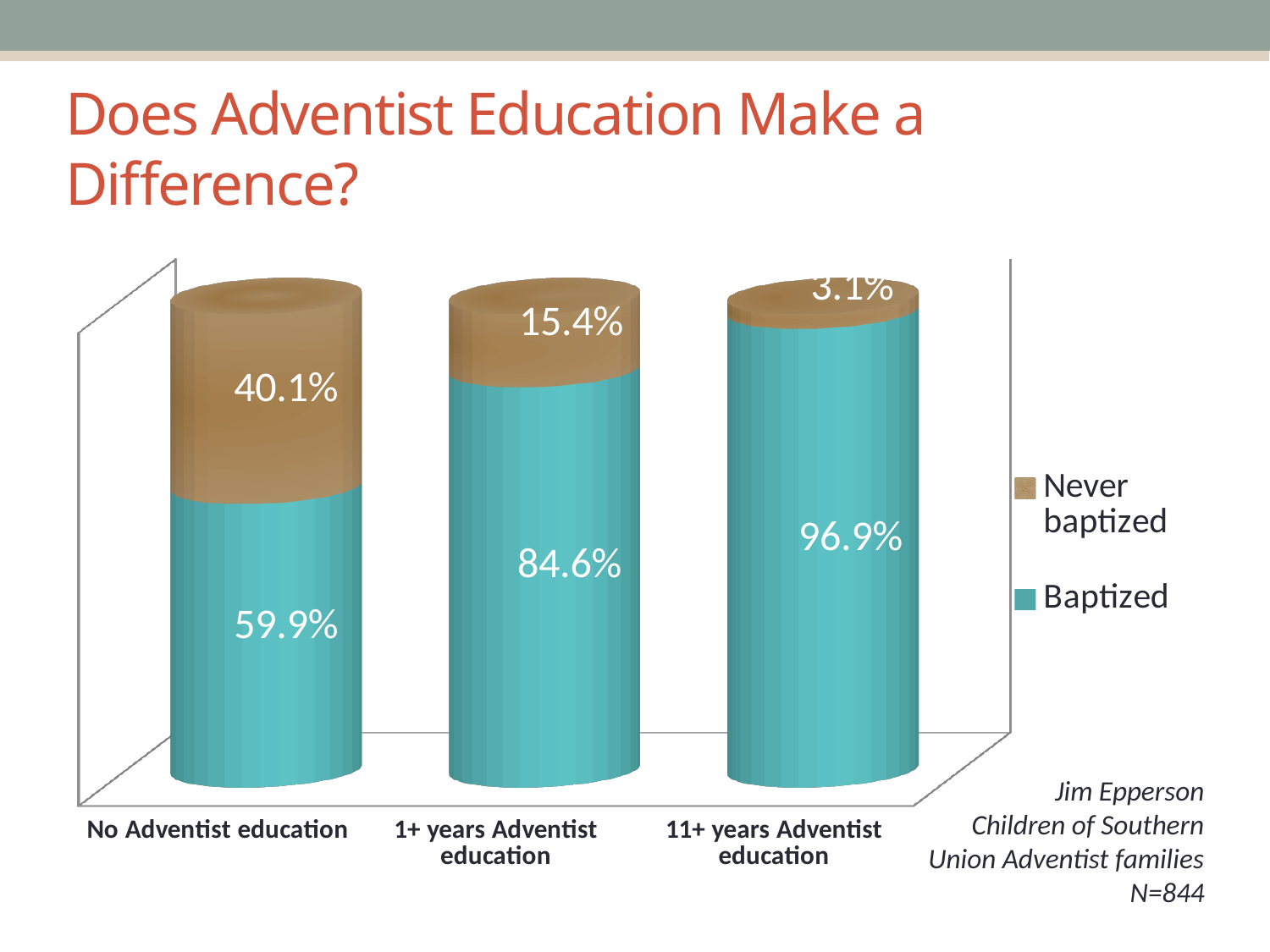
What is the difference between the Baptized percentages for '11+ years Adventist education' and 'No Adventist education'? 37 percentage points How many series does the legend list? 2 Which category has the highest Baptized percentage? 11+ years Adventist education What is the Never baptized percentage for the '1+ years Adventist education' category? 15.4% How many categories are shown on the x axis? 3 Does the Baptized percentage rise or fall as years of Adventist education increase along the x axis? Rise Which is larger: the Never baptized percentage for 'No Adventist education' or for '1+ years Adventist education'? No Adventist education What is the Never baptized percentage for the '11+ years Adventist education' category? 3.1% What is the Baptized percentage for the '11+ years Adventist education' category? 96.9% Which category has the lowest Never baptized percentage? 11+ years Adventist education What is the Baptized percentage for the 'No Adventist education' category? 59.9% What kind of chart is shown on the slide? Stacked bar chart